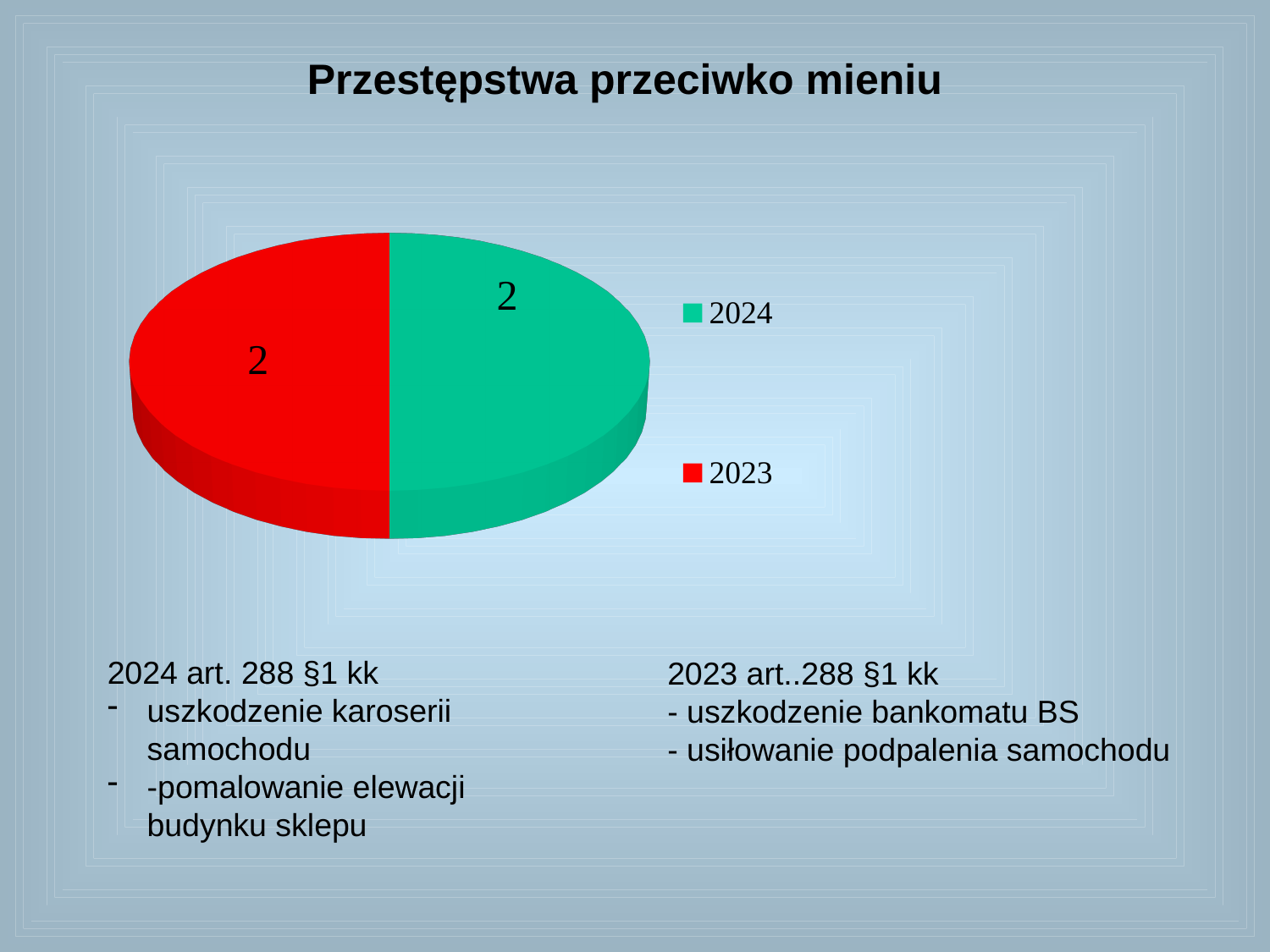
What share of the pie does the 2023 slice represent? 50% Which colour represents 2023 in the pie chart? red How many slices does the pie chart have? 2 Is the value for 2024 larger than, smaller than, or equal to the value for 2023 in the pie chart? equal What is the title of the slide containing the pie chart? Przestępstwa przeciwko mieniu What is the total of all slices in the pie chart? 4 How many entries does the legend of the pie chart list? 2 What is the value of the 2024 slice in the pie chart? 2 What kind of chart is shown on the slide? pie chart What is the value of the 2023 slice in the pie chart? 2 What is the difference between the 2024 and 2023 values in the pie chart? 0 What share of the pie does the 2024 slice represent? 50%